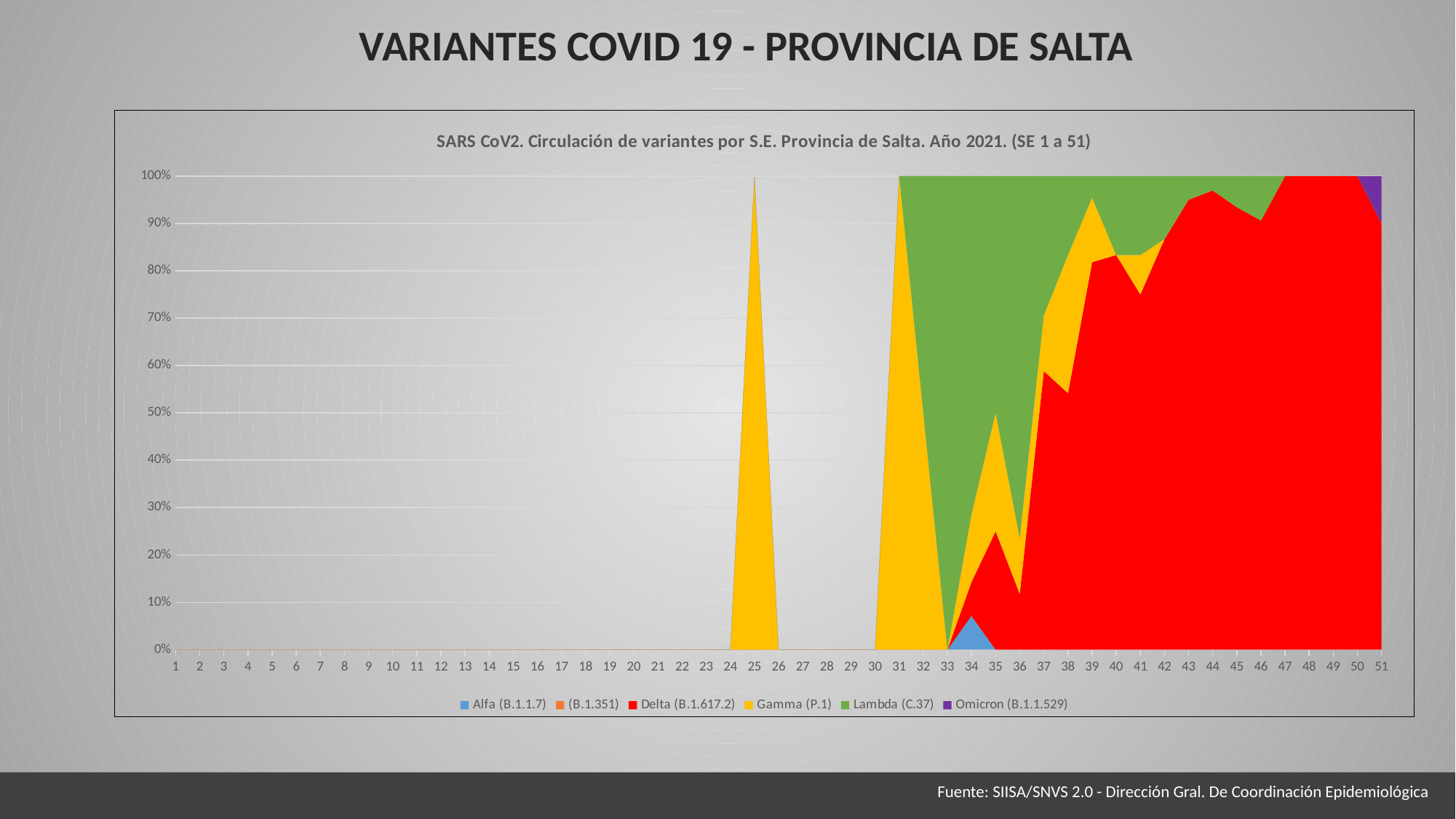
Which variant is represented by the red area? Delta (B.1.617.2) What kind of chart is shown on the slide? Area chart At week 38, which has the larger share: Delta (B.1.617.2) or Gamma (P.1)? Delta (B.1.617.2) How many epidemiological weeks (x-axis points) are plotted on the chart? 51 What is the title of the chart inside the plot area? SARS CoV2. Circulación de variantes por S.E. Provincia de Salta. Año 2021. (SE 1 a 51) Which variant appears for the first time at week 51? Omicron (B.1.1.529) Is the share of Alfa (B.1.1.7) at week 34 greater or less than 10%? less Which variant accounts for the largest share at week 45? Delta (B.1.617.2) How many series does the legend list? 6 Which variant is the only one present at week 25? Gamma (P.1) Is the share of Delta (B.1.617.2) at week 44 greater or less than 90%? greater Is the share of Delta (B.1.617.2) at week 37 greater or less than 50%? greater